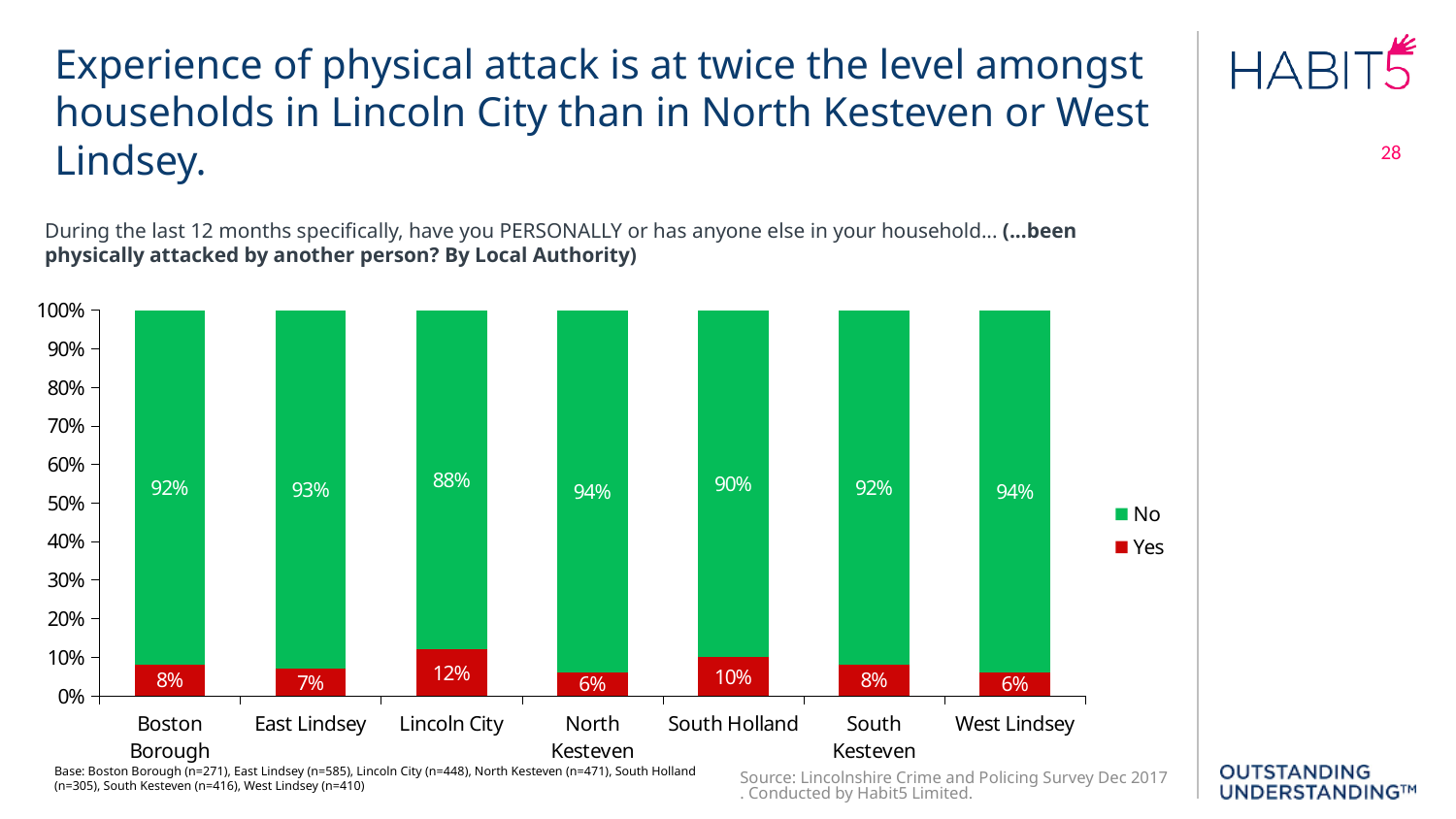
How many local authorities are shown on the x axis? 7 What percentage of households in Lincoln City answered Yes to having been physically attacked? 12% Which local authority has the lowest No percentage? Lincoln City How many series does the legend list? 2 What is the difference between the Yes percentage for Lincoln City and for North Kesteven? 6% What is the total of the stacked bar for South Kesteven? 100% What is the No value for South Holland? 90% What kind of chart is shown on the slide? Stacked bar chart Which has a higher Yes percentage, South Holland or Boston Borough? South Holland What percentage of households in East Lindsey answered Yes? 7% Which colour represents the Yes responses in the chart? Red Which local authority has the highest Yes percentage? Lincoln City